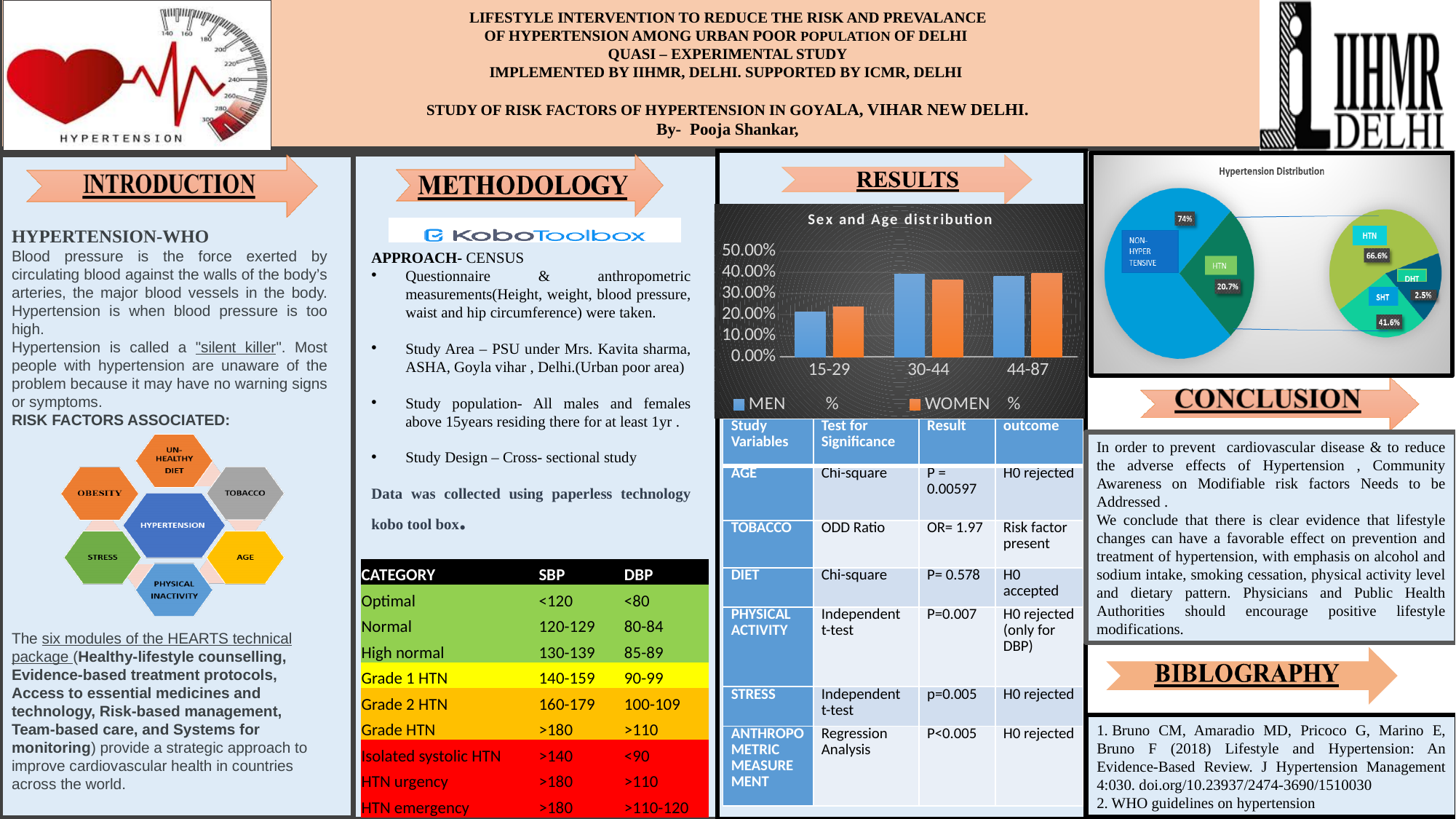
How many series does the legend of the "Sex and Age distribution" chart list? 2 In the "Sex and Age distribution" chart, is the value for WOMEN in the 30-44 group greater or less than 30.00%? greater In the "Sex and Age distribution" chart, which is larger for MEN: the 15-29 group or the 30-44 group? 30-44 In the "Hypertension Distribution" chart, what value is labelled for DHT? 2.5% What kind of chart is the "Sex and Age distribution" chart? bar chart How many age groups are shown on the x axis of the "Sex and Age distribution" chart? 3 In the "Sex and Age distribution" chart, which age group has the lowest value for MEN? 15-29 In the "Hypertension Distribution" chart, what value is labelled for SHT? 41.6% In the "Sex and Age distribution" chart, is the value for MEN in the 44-87 group greater or less than 30.00%? greater In the "Sex and Age distribution" chart, is the value for MEN in the 15-29 group greater or less than 30.00%? less What kind of chart is the "Hypertension Distribution" chart? pie chart In the "Hypertension Distribution" chart, what share is labelled for NON-HYPERTENSIVE? 74%